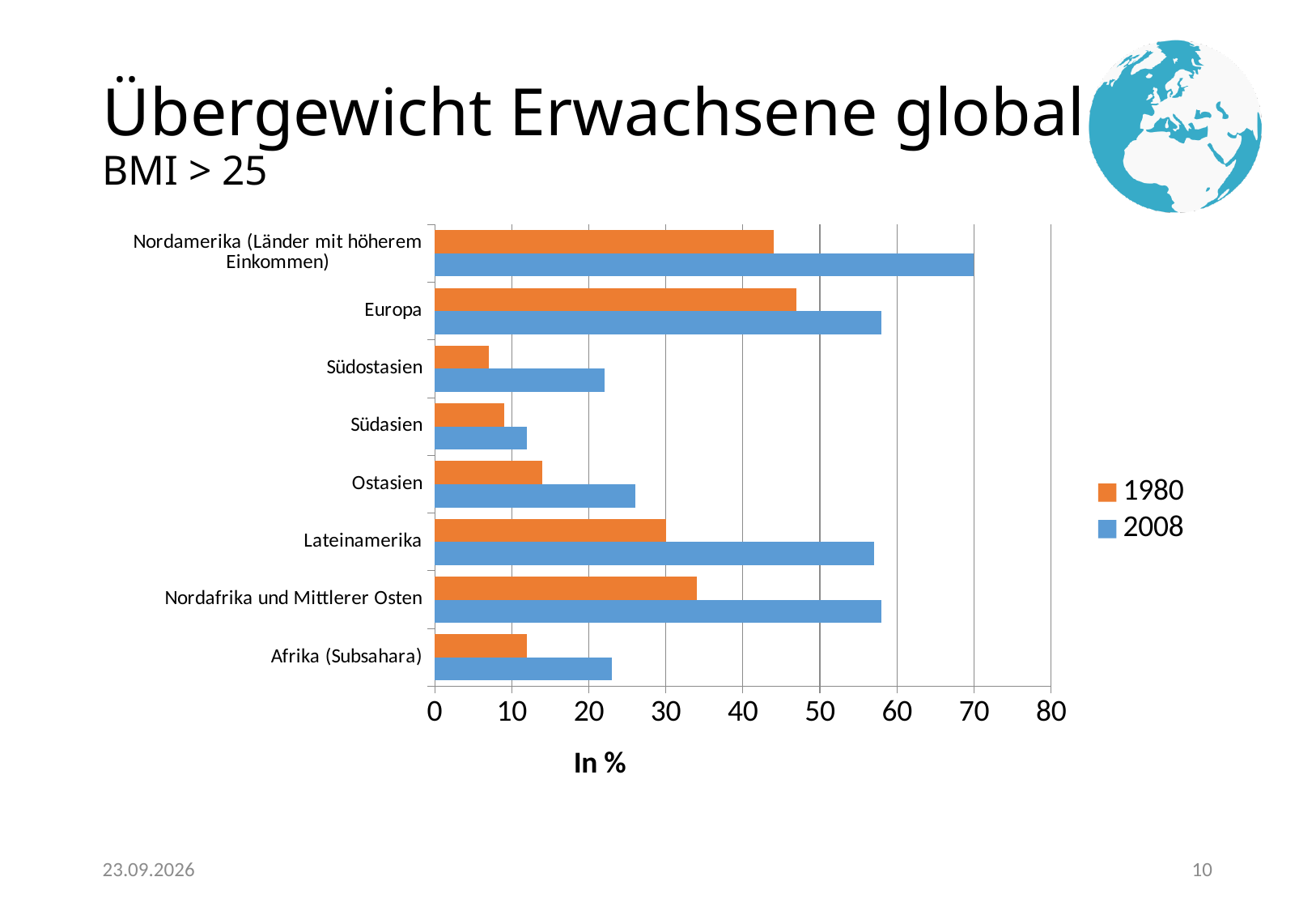
Is the 2008 value for Nordafrika und Mittlerer Osten greater or less than 50? greater What is the label of the horizontal axis? In % How many regions (categories) are shown on the chart? 8 Is the 1980 value for Südostasien greater or less than 10? less How many series does the legend list? 2 What is the 2008 value for Nordamerika (Länder mit höherem Einkommen)? 70 What kind of chart is shown on the slide? bar chart Which region has the highest value for 2008? Nordamerika (Länder mit höherem Einkommen) Which region has the lowest value for 2008? Südasien For Afrika (Subsahara), which series has the larger value, 1980 or 2008? 2008 Is the 2008 value for Ostasien greater or less than 20? greater Which is larger: the 2008 value for Lateinamerika or the 2008 value for Ostasien? Lateinamerika